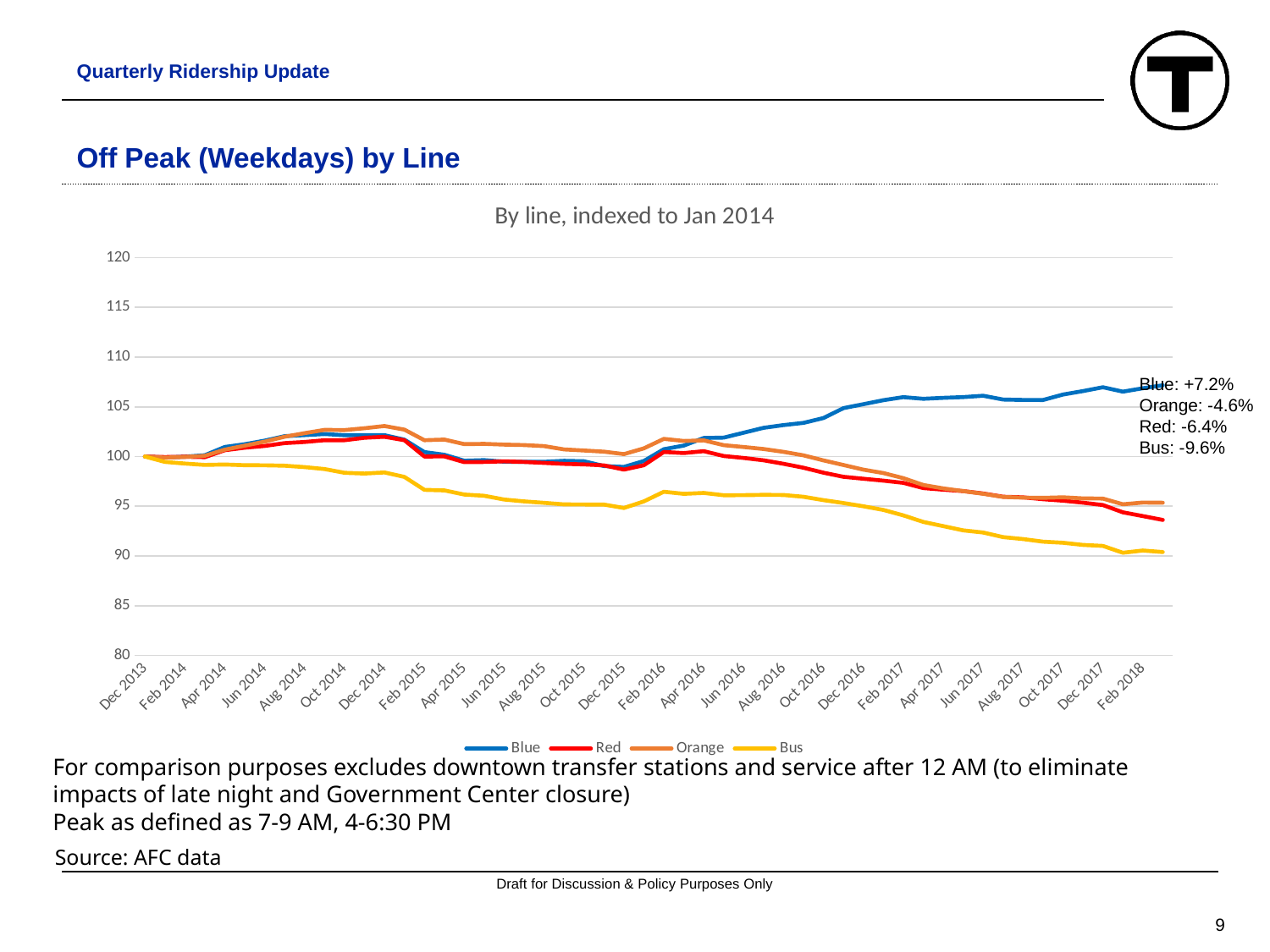
Does the Blue line rise or fall overall from Dec 2013 to Feb 2018? rise How many series does the legend list? 4 Which series has the lowest value at the end of the chart (Feb 2018)? Bus What percentage change is annotated for the Orange line? -4.6% Which series are listed in the legend? Blue, Red, Orange, Bus What percentage change is annotated for the Bus line? -9.6% What percentage change is annotated for the Blue line? +7.2% What kind of chart is shown on the slide? line chart What is the title of the chart? By line, indexed to Jan 2014 What percentage change is annotated for the Red line? -6.4% Is the value for Bus at Feb 2018 greater or less than 95? less Which series has the highest value at the end of the chart (Feb 2018)? Blue